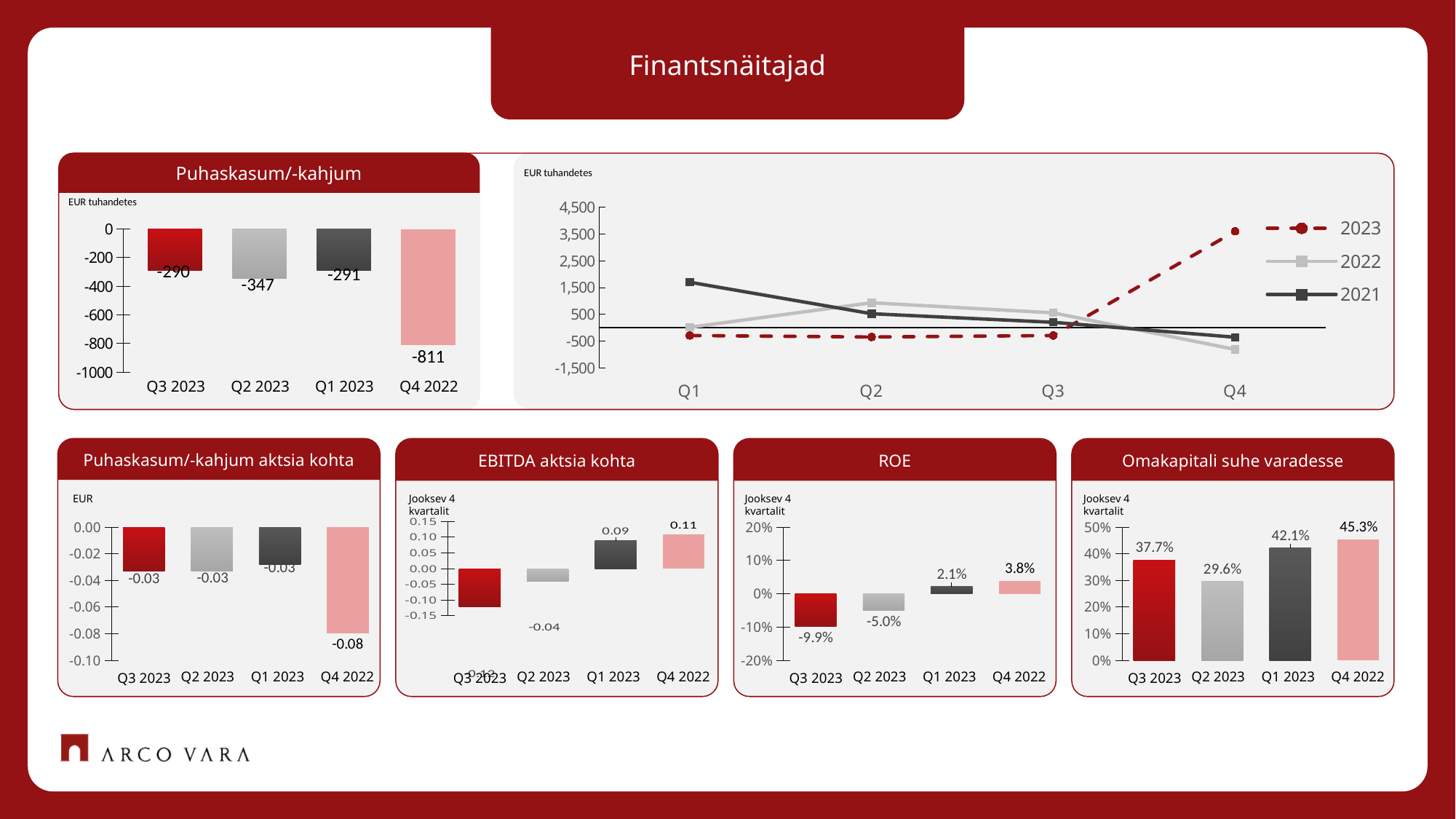
In the Puhaskasum/-kahjum chart, what is the difference between the Q3 2023 and Q4 2022 values? 521 In the Omakapitali suhe varadesse chart, which quarter has the highest value? Q4 2022 In the Puhaskasum/-kahjum aktsia kohta chart, what is the value for Q4 2022? -0.08 In the EBITDA aktsia kohta chart, what is the value for Q1 2023? 0.09 In the ROE chart, what is the value for Q3 2023? -9.9% In the Omakapitali suhe varadesse chart, what is the difference between the Q1 2023 and Q2 2023 values? 12.5% In the top-right line chart, which series has the highest value at Q1? 2021 How many series does the legend of the top-right line chart list? 3 In the Puhaskasum/-kahjum chart, which quarter has the lowest value? Q4 2022 In the ROE chart, which is larger, the value for Q1 2023 or Q4 2022? Q4 2022 In the Puhaskasum/-kahjum chart, what is the value for Q2 2023? -347 In the top-right line chart, is the 2023 value for Q4 greater or less than 2,500? greater